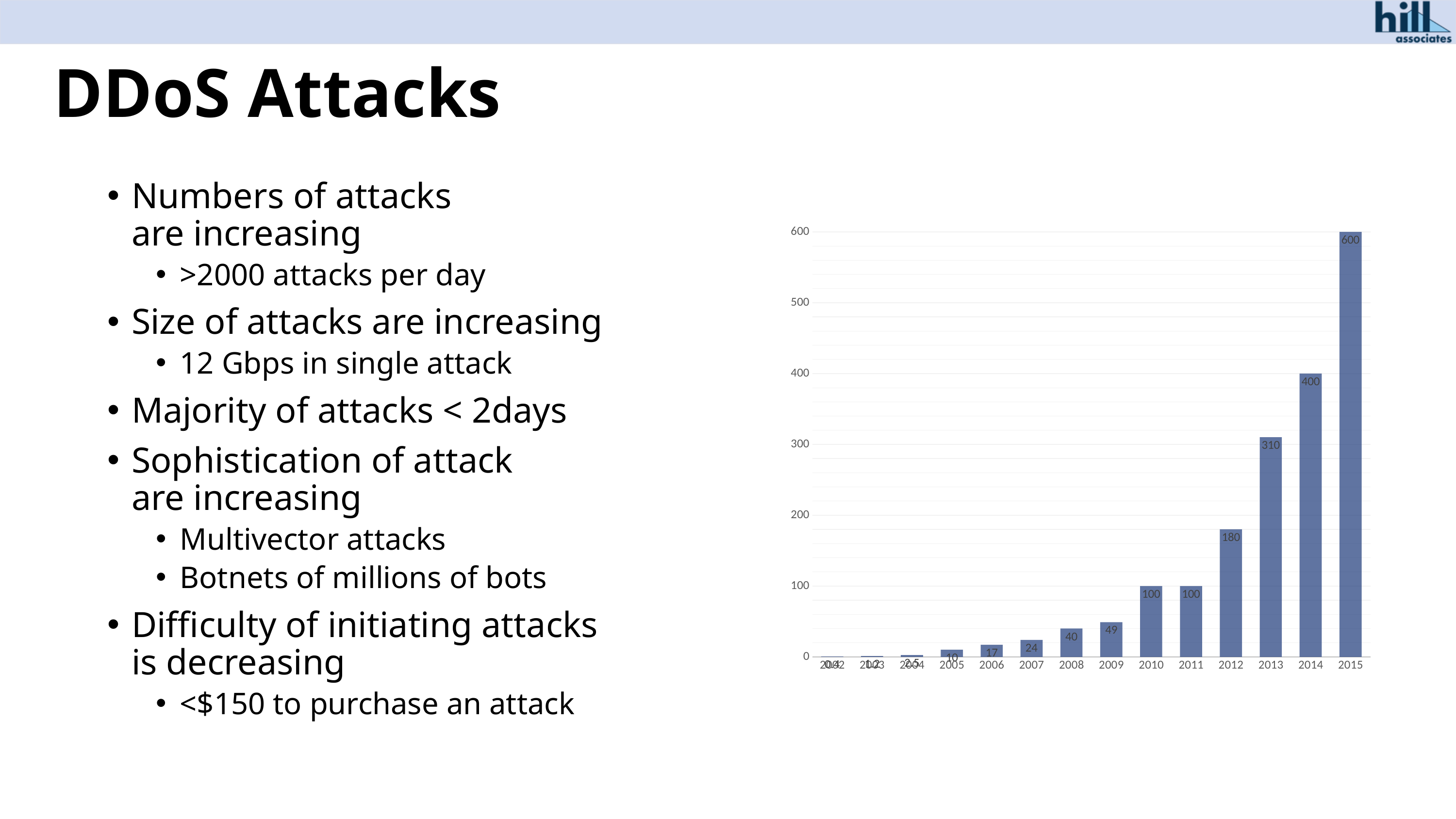
What kind of chart is shown on the slide? bar chart Which year has the highest value? 2015 What is the value for 2015? 600 What is the value for 2008? 40 Is the value for 2014 greater or less than 300? greater Do the values generally rise or fall from 2005 to 2015? rise What is the value for 2013? 310 What is the value for 2006? 17 Which is larger, the value for 2009 or the value for 2007? 2009 What is the difference between the values for 2012 and 2011? 80 What is the difference between the values for 2015 and 2014? 200 What is the highest value shown on the vertical axis? 600